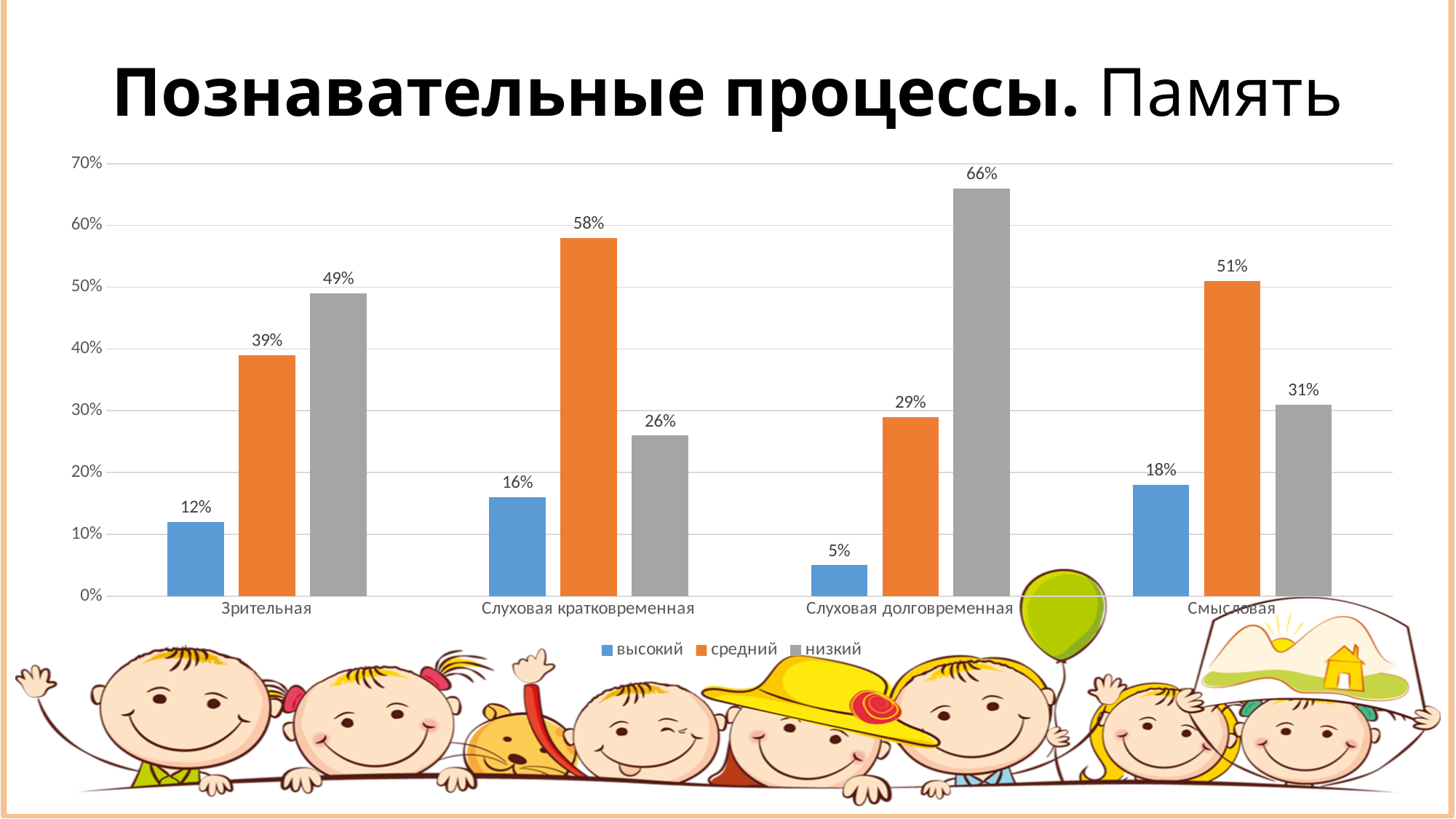
Which category has the highest 'средний' value? Слуховая кратковременная Which colour represents the 'низкий' series? grey What is the value of the 'высокий' series for 'Смысловая'? 18% Is the 'низкий' value for 'Слуховая кратковременная' greater or less than 30%? less What is the value of the 'низкий' series for 'Слуховая долговременная'? 66% What is the difference between the 'низкий' and 'высокий' values for 'Зрительная'? 37% What is the value of the 'средний' series for 'Зрительная'? 39% How many series does the legend list? 3 What kind of chart is shown on the slide? bar chart Which category has the lowest 'высокий' value? Слуховая долговременная How many categories are shown on the x axis? 4 Which is larger for 'Смысловая': the 'средний' value or the 'низкий' value? средний